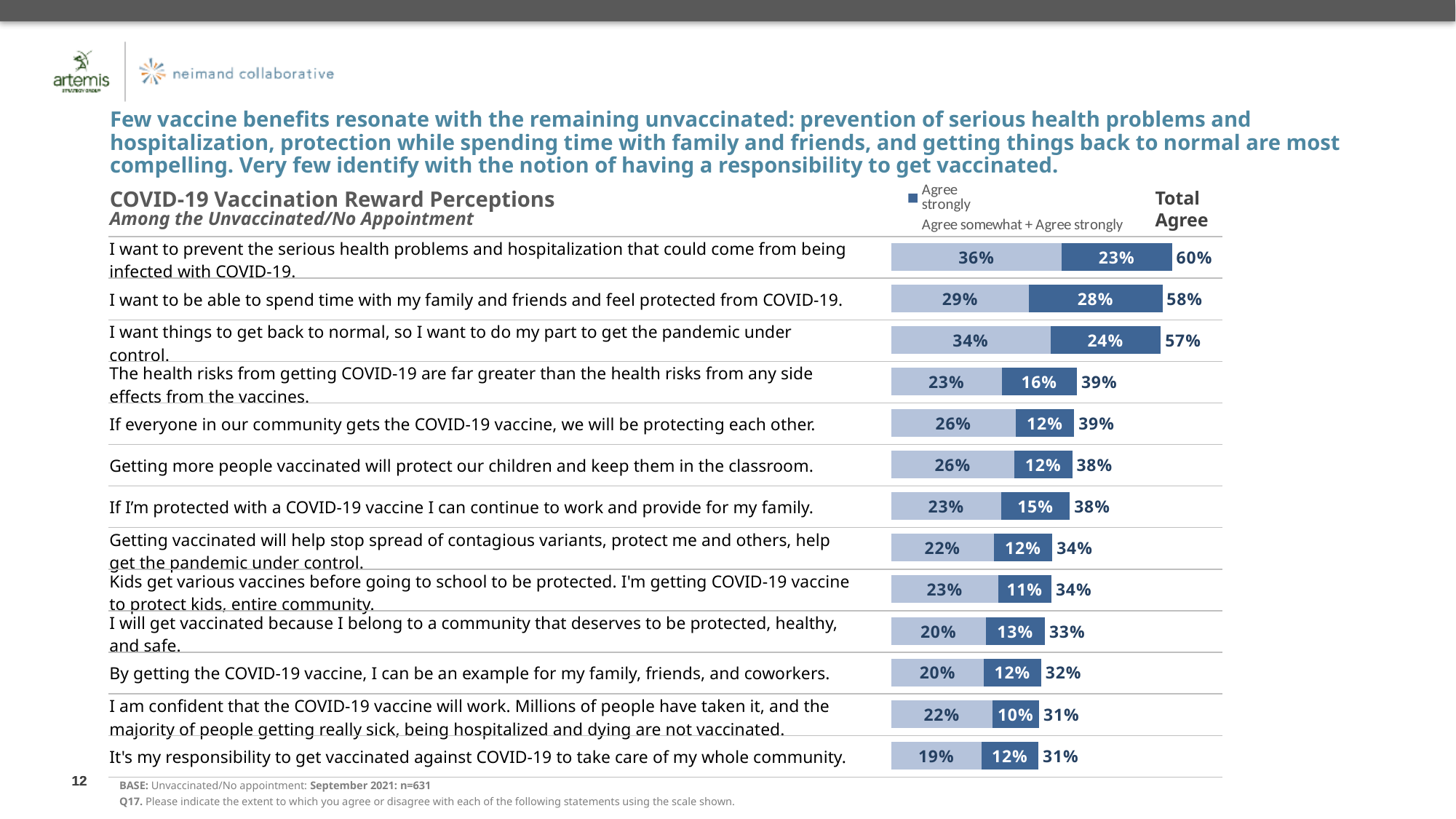
What is the Total Agree value for the statement 'I want to prevent the serious health problems and hospitalization that could come from being infected with COVID-19'? 60% What is the difference in Total Agree between 'I want to prevent the serious health problems and hospitalization...' and 'It's my responsibility to get vaccinated against COVID-19...'? 29 percentage points What is the title of the chart? COVID-19 Vaccination Reward Perceptions What kind of chart is shown on the slide? Stacked bar chart What percentage agree strongly with 'I want to be able to spend time with my family and friends and feel protected from COVID-19'? 28% How many statements are plotted in the chart? 13 Which statement has the lowest Agree strongly percentage? I am confident that the COVID-19 vaccine will work. Millions of people have taken it, and the majority of people getting really sick, being hospitalized and dying are not vaccinated (10%) Which statement has the highest Total Agree value? I want to prevent the serious health problems and hospitalization that could come from being infected with COVID-19 (60%) Which has a higher Agree strongly percentage: 'I want to be able to spend time with my family and friends...' or 'I want things to get back to normal...'? I want to be able to spend time with my family and friends and feel protected from COVID-19 Which statement has the highest Agree strongly percentage? I want to be able to spend time with my family and friends and feel protected from COVID-19 (28%) What is the Total Agree for 'The health risks from getting COVID-19 are far greater than the health risks from any side effects from the vaccines'? 39% What percentage agree somewhat with 'It's my responsibility to get vaccinated against COVID-19 to take care of my whole community'? 19%